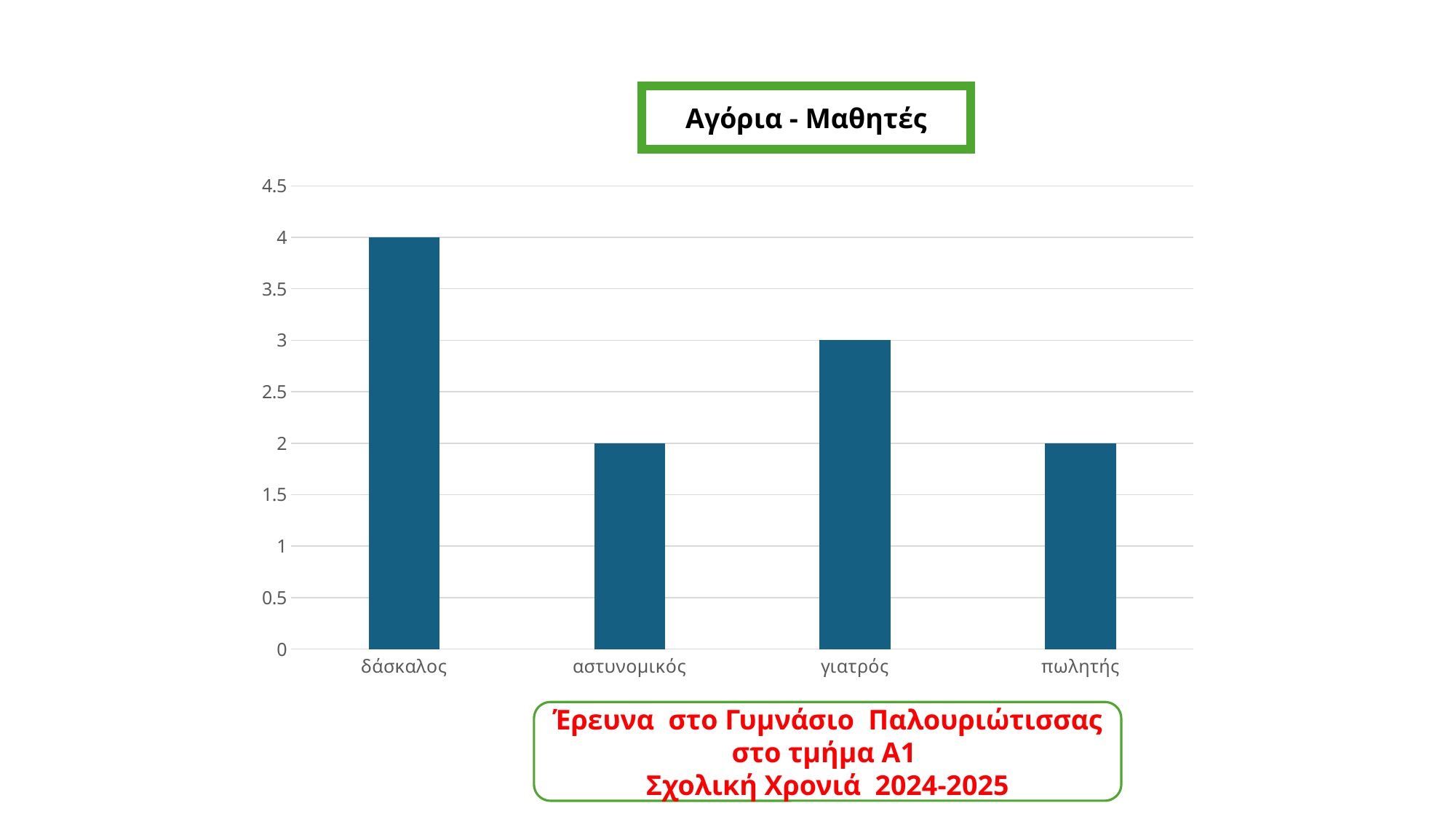
Is the value for γιατρός greater or less than 2.5? greater What is the value for αστυνομικός? 2 What kind of chart is shown on the slide? bar chart Which is larger, the value for γιατρός or the value for αστυνομικός? γιατρός What is the value for δάσκαλος? 4 What is the title of the chart? Αγόρια - Μαθητές What is the difference between the values for δάσκαλος and γιατρός? 1 What is the value for γιατρός? 3 What is the value for πωλητής? 2 Which category has the highest value? δάσκαλος How many categories are shown on the x axis? 4 What is the difference between the values for δάσκαλος and πωλητής? 2